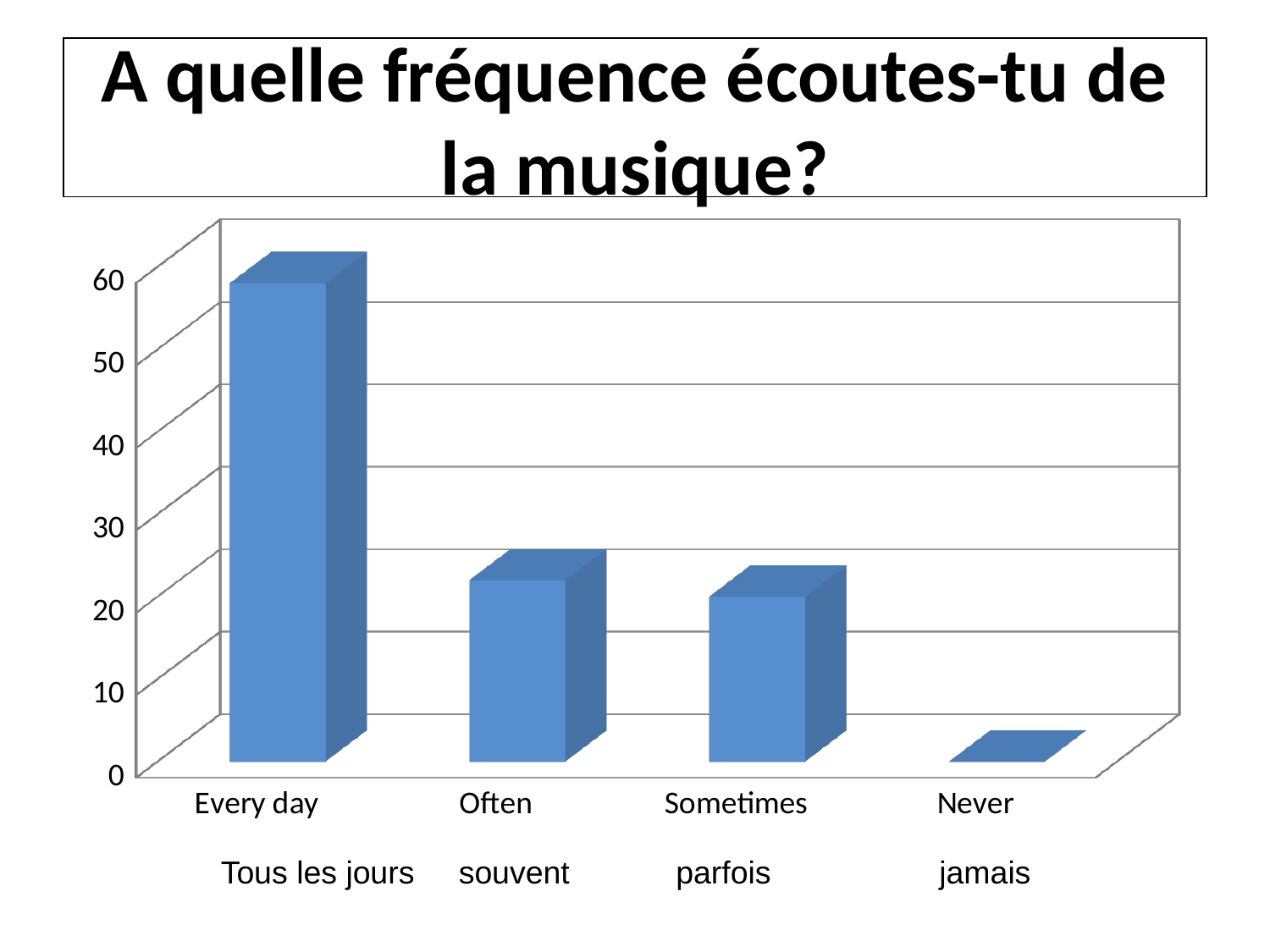
Is the value for Never greater or less than 10? less Which is larger, the value for Sometimes or the value for Never? Sometimes Is the value for Sometimes greater or less than 10? greater What kind of chart is shown on the slide? bar chart Is the value for Often greater or less than 30? less Which category has the lowest value? Never How many categories are shown on the x axis? 4 Which is larger, the value for Every day or the value for Often? Every day Which category has the highest value? Every day What is the title of the slide above the chart? A quelle fréquence écoutes-tu de la musique? Do the values rise or fall from left to right along the x axis? fall